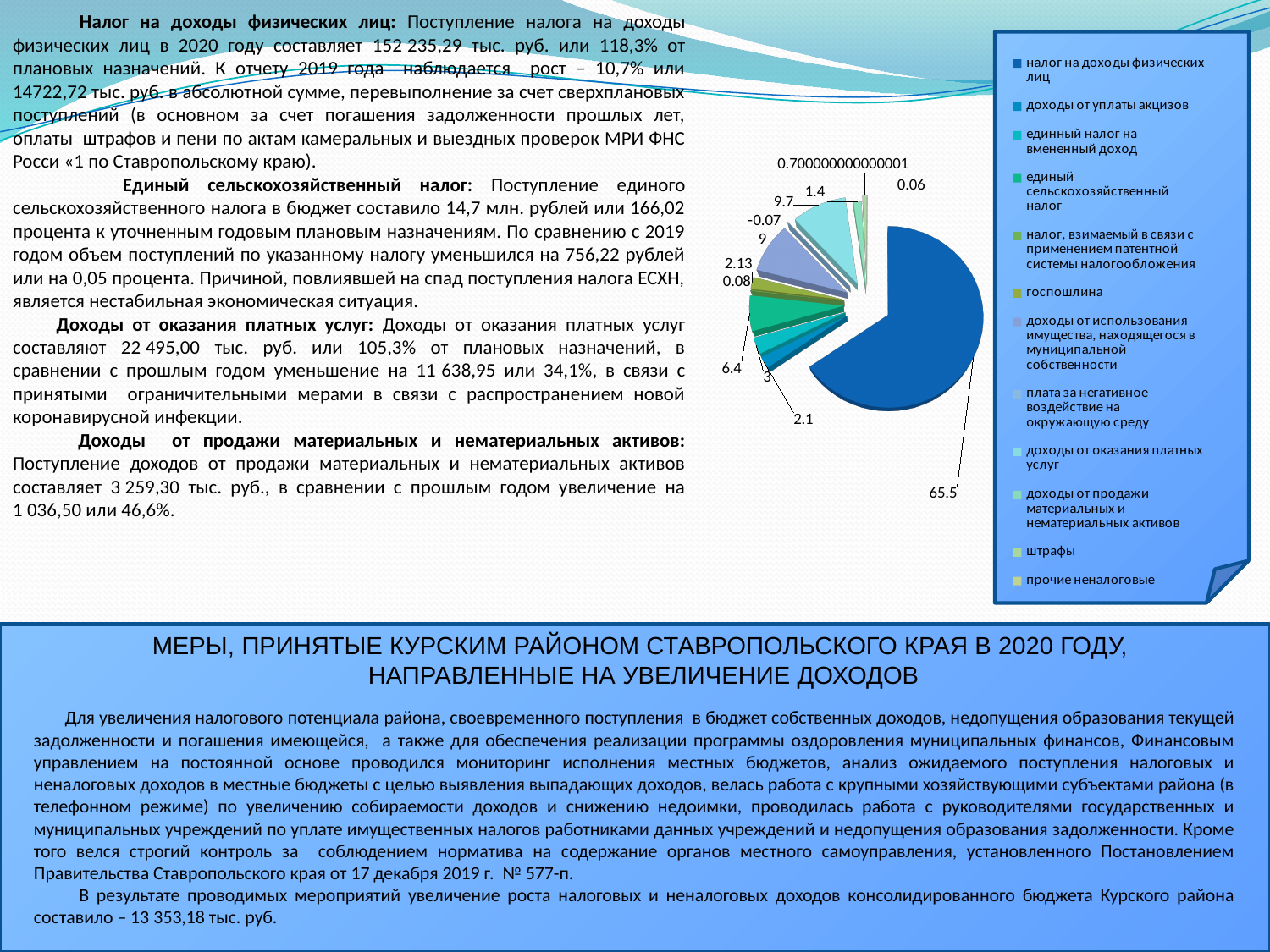
Which category has the largest slice in the pie chart? налог на доходы физических лиц What kind of chart is shown on the right side of the slide? Pie chart What is the value shown for 'единый сельскохозяйственный налог' in the pie chart? 6.4 How many entries does the legend of the pie chart list? 12 What is the difference between the slice labeled 65.5 and the slice labeled 9.7 in the pie chart? 55.8 Which slice is larger in the pie chart, the one labeled 9.7 or the one labeled 6.4? 9.7 How many data labels are printed on the pie chart? 12 What is the value shown for 'доходы от оказания платных услуг' in the pie chart? 9.7 What is the value printed on the largest slice of the pie chart? 65.5 Which entry appears first in the legend of the pie chart? налог на доходы физических лиц What is the longest numeric label printed on the pie chart? 0.700000000000001 What is the value shown for 'налог на доходы физических лиц' in the pie chart? 65.5